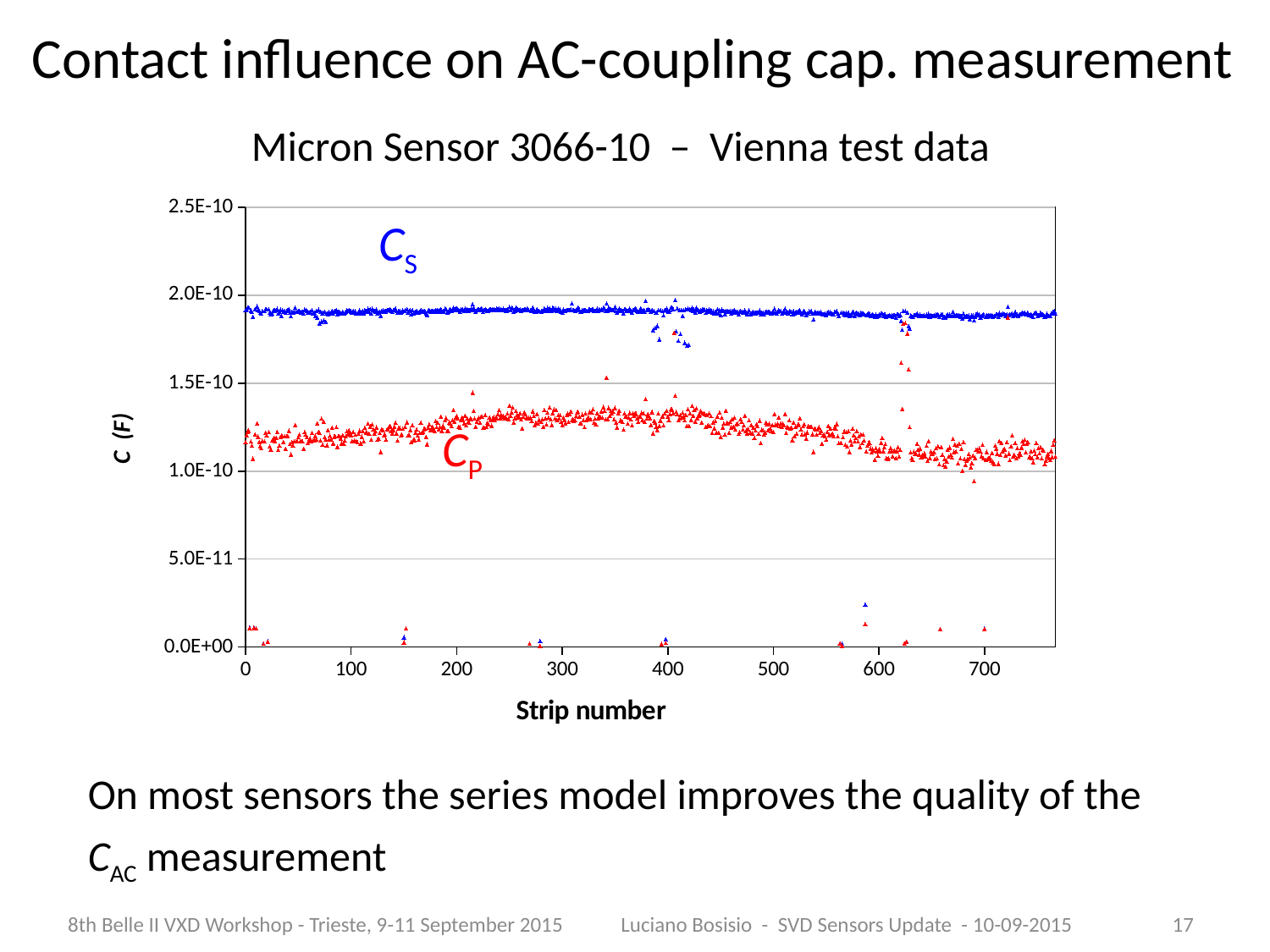
What is the title of the chart? Micron Sensor 3066-10 – Vienna test data Is the value of C_S at strip number 500 greater or less than 2.0E-10? less How many data series are plotted on the chart? 2 Is the value of C_S at strip number 100 greater or less than 1.5E-10? greater What is the label of the x axis of the chart? Strip number What is the highest value shown on the y axis of the chart? 2.5E-10 Is the value of C_P at strip number 300 greater or less than 1.5E-10? less What kind of chart is shown on the slide? scatter chart Which series has the higher values across the strip range, C_S or C_P? C_S Does the C_P series rise or fall between strip number 400 and strip number 700? fall